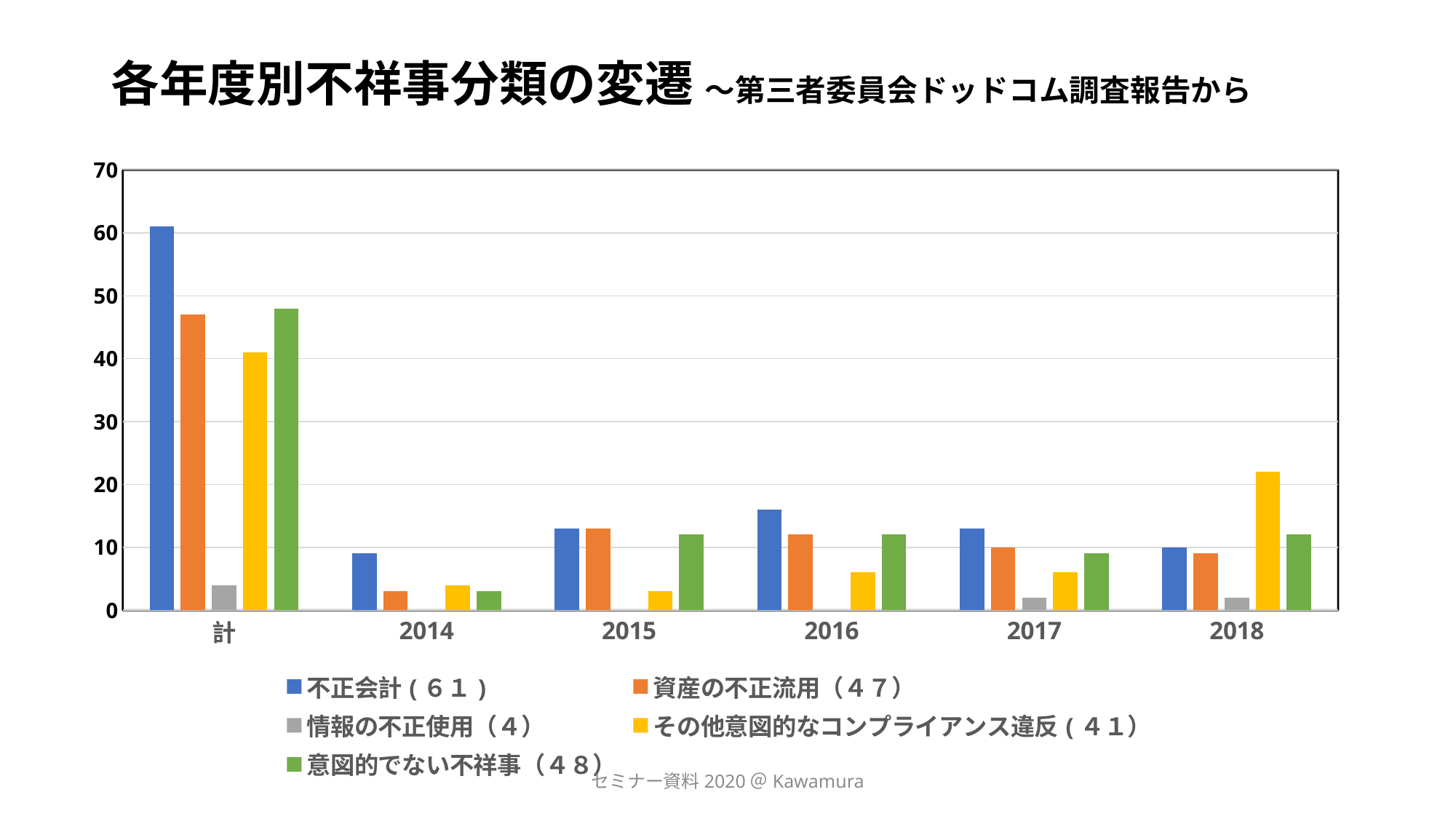
Is the value for 不正会計 in 2014 greater or less than 10? less Does the value for 不正会計 rise or fall from 2014 to 2016? rise Is the value for その他意図的なコンプライアンス違反 in 2018 greater or less than 20? greater According to the legend, what is the total (計) value for 不正会計? ６１ What is the difference between the 計 values of 不正会計 and 資産の不正流用? 14 What type of chart is shown on the slide? bar chart Which series has the lowest bar in the 計 category? 情報の不正使用 How many series does the legend list? 5 According to the legend, what is the total (計) value for 情報の不正使用? ４ How many categories are shown on the x axis? 6 Which series has the highest bar in the 計 category? 不正会計 In the 計 category, which is larger: 不正会計 or その他意図的なコンプライアンス違反? 不正会計